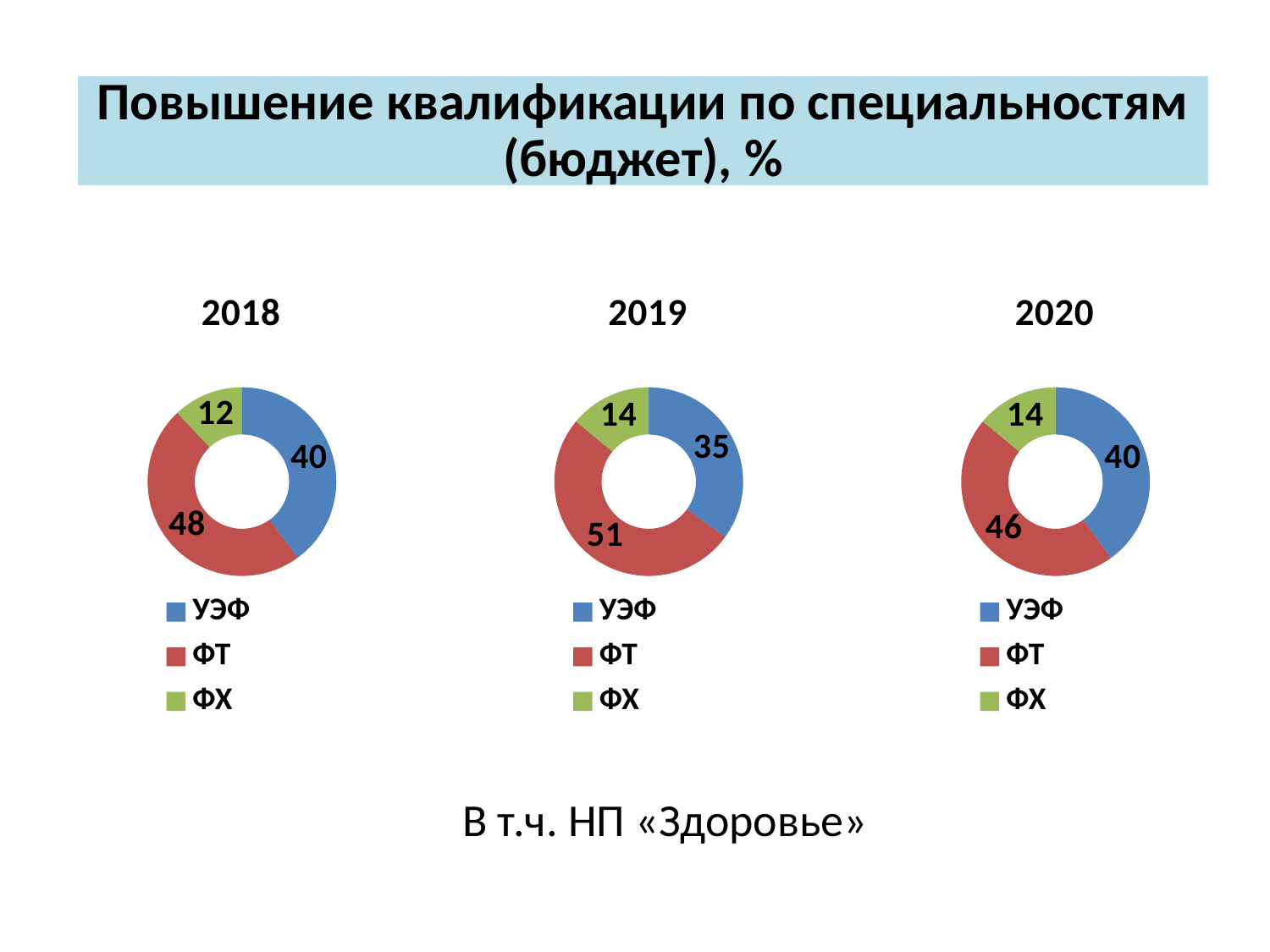
How does the value for ФХ change from the 2018 chart to the 2019 chart? rises from 12 to 14 What kind of chart is the 2020 chart? doughnut chart In the 2020 chart, what is the value for ФХ? 14 In the 2018 chart, what is the total of the three values shown? 100 In the 2018 chart, which category has the largest share? ФТ In the 2020 chart, what is the difference between the values for ФТ and УЭФ? 6 In the 2019 chart, which is larger, the value for ФТ or the value for УЭФ? ФТ In the 2019 chart, what is the value for УЭФ? 35 How many categories does the 2018 chart show? 3 Which colour represents ФТ in the legend of the 2019 chart? red In the 2019 chart, which category has the smallest share? ФХ In the 2018 chart, what is the value for ФТ? 48